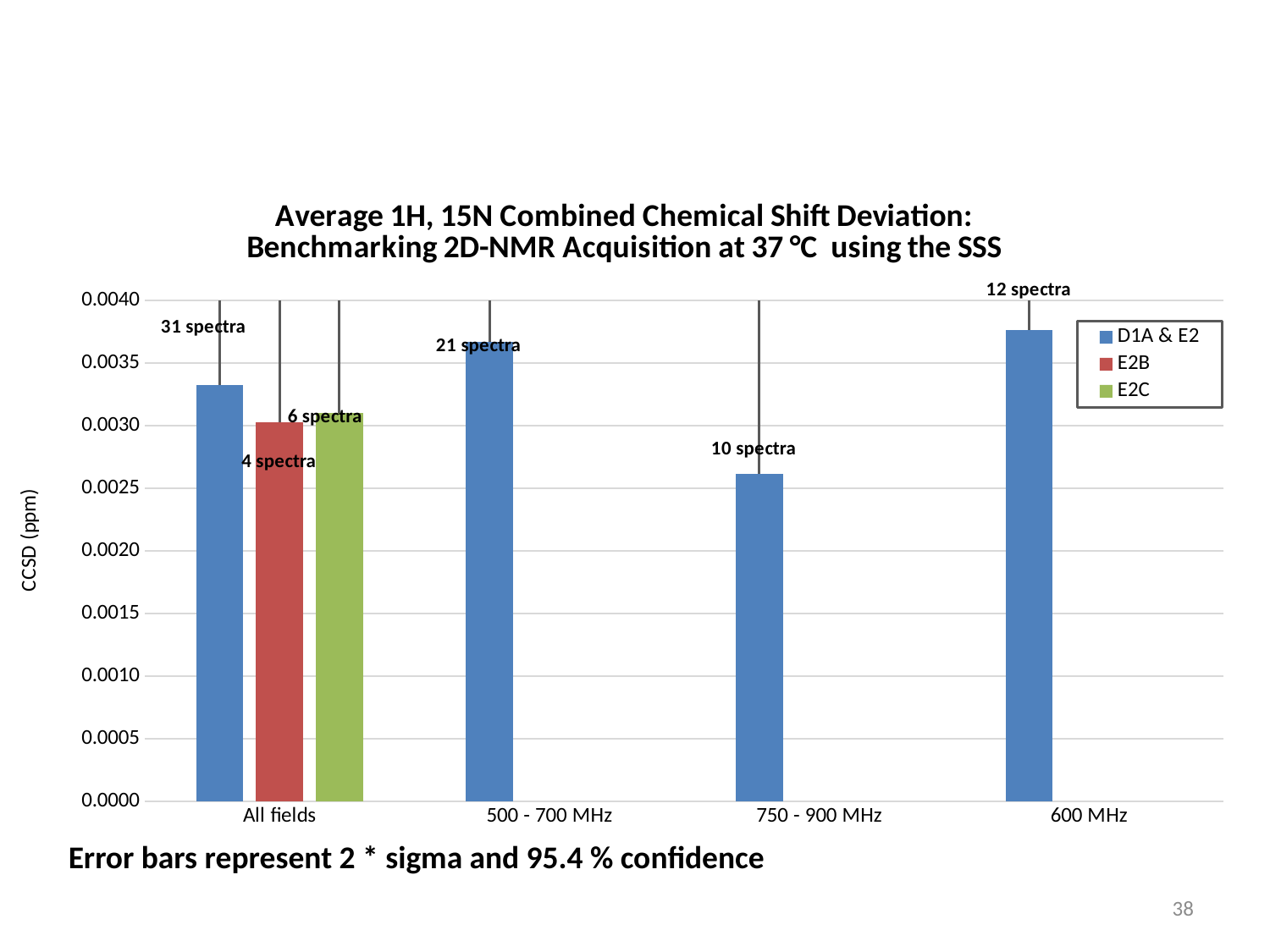
Which is larger, the D1A & E2 value for 600 MHz or for 750 - 900 MHz? 600 MHz Is the D1A & E2 value for 750 - 900 MHz greater or less than 0.0030? less Is the D1A & E2 value for 500 - 700 MHz greater or less than 0.0035? greater Which is larger in the All fields category, the D1A & E2 bar or the E2B bar? D1A & E2 How many categories are shown on the x axis? 4 Which category has the highest D1A & E2 bar? 600 MHz What kind of chart is shown on the slide? Bar chart How many series does the legend list? 3 Is the D1A & E2 value for 600 MHz greater or less than 0.0035? greater Which category has the lowest D1A & E2 bar? 750 - 900 MHz What label is printed above the 600 MHz bar? 12 spectra